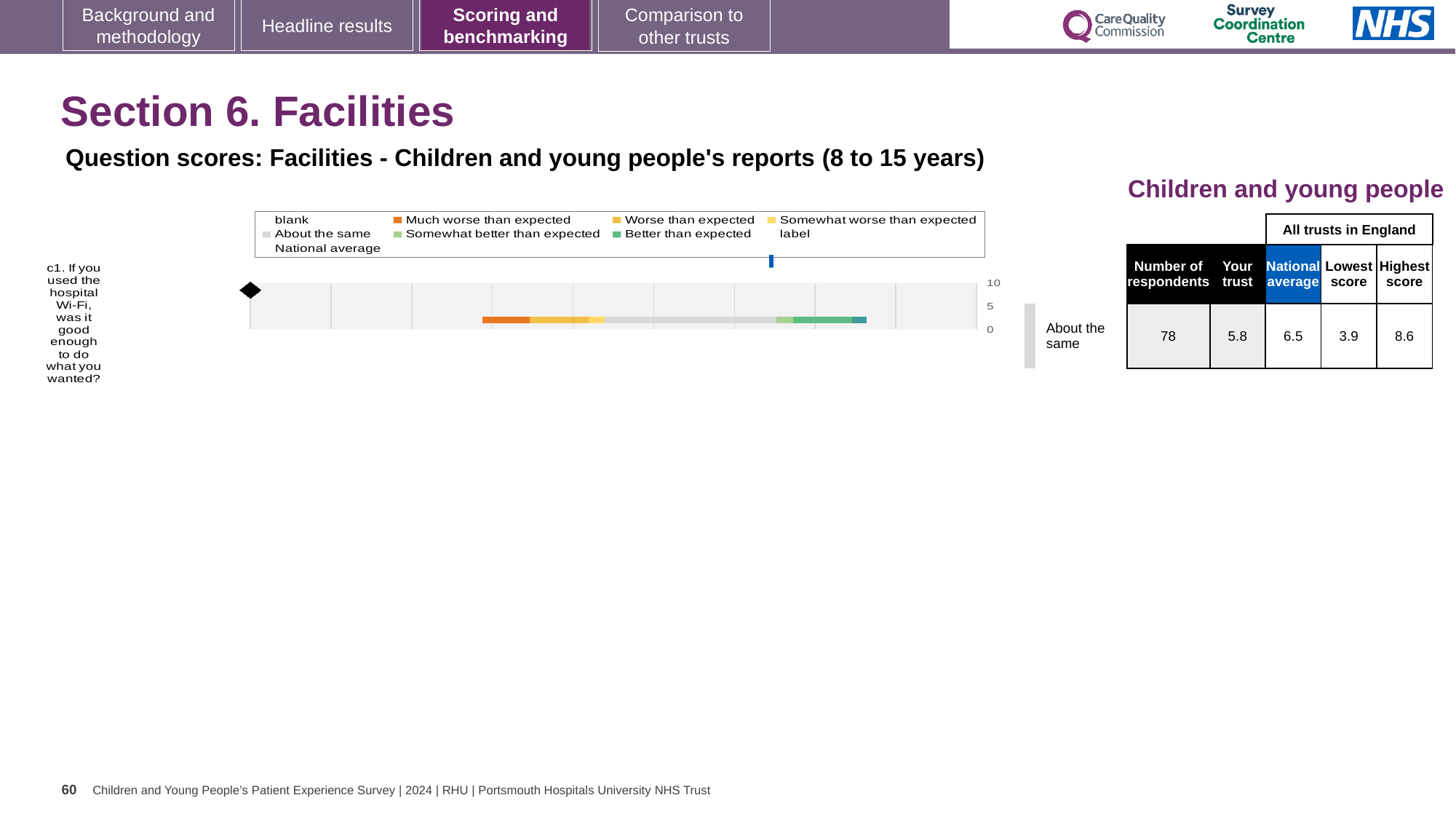
What is the 'Your trust' score for question c1 about the hospital Wi-Fi? 5.8 By how much does the national average exceed the 'Your trust' score for question c1? 0.7 Which is larger for question c1: the 'Your trust' score or the national average? National average What is the difference between the highest score and the lowest score for question c1? 4.7 What benchmark category is the trust's result for question c1 placed in? About the same What is the highest score among all trusts in England for question c1? 8.6 What is the lowest score among all trusts in England for question c1? 3.9 What kind of chart is used to show the question score for c1? bar chart How many respondents answered question c1? 78 How many survey questions are plotted on the chart? 1 What is the national average score for question c1? 6.5 Which legend entry is shown in orange? Much worse than expected